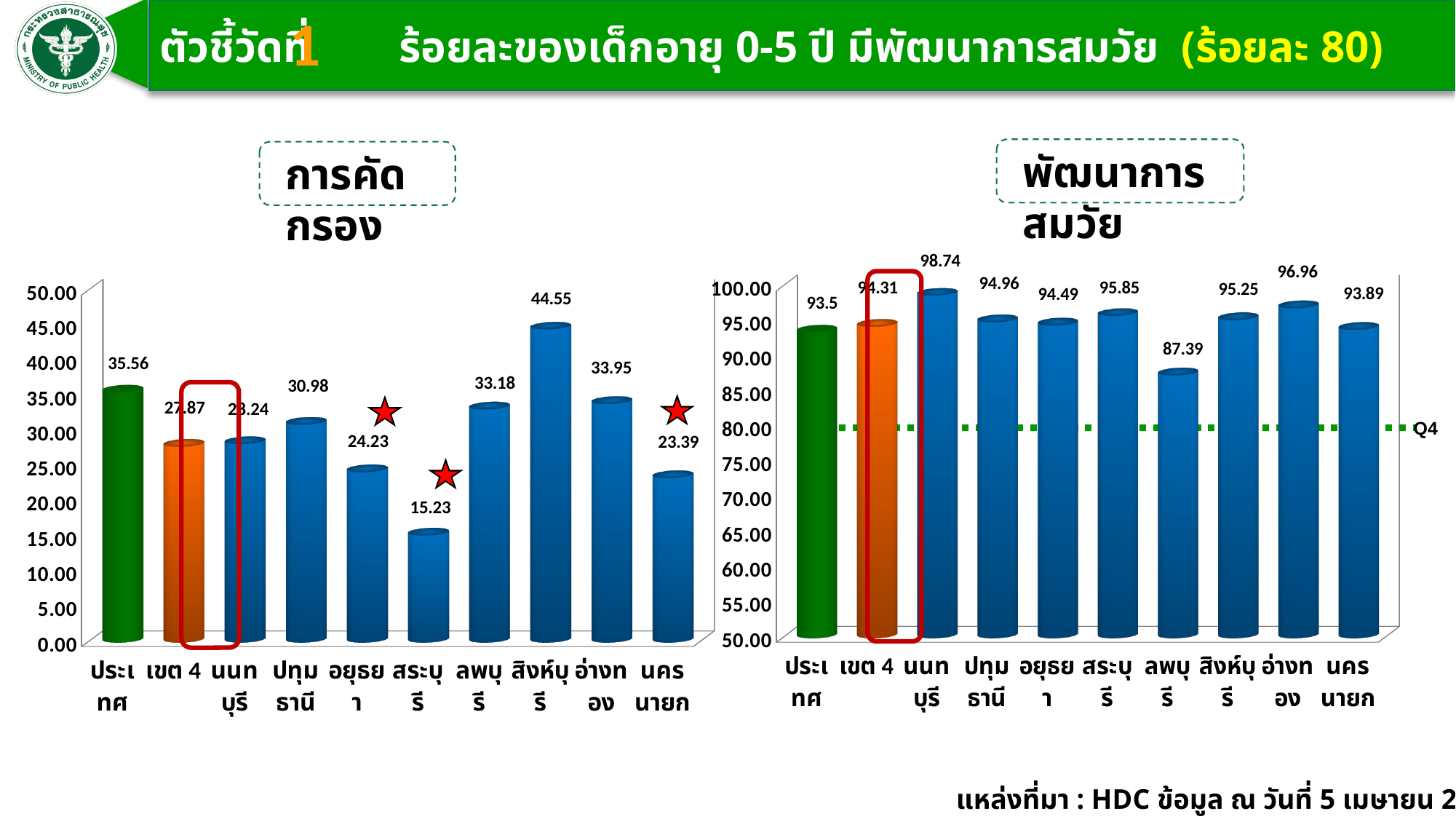
In the left chart (การคัดกรอง), which category has the lowest value? สระบุรี In the left chart (การคัดกรอง), what is the value for สิงห์บุรี? 44.55 In the right chart (พัฒนาการสมวัย), which category has the lowest value? ลพบุรี In the left chart (การคัดกรอง), what is the value for ประเทศ? 35.56 In the right chart (พัฒนาการสมวัย), what is the value for ลพบุรี? 87.39 How many categories are shown on the x axis of the left chart (การคัดกรอง)? 10 What type of chart is the right chart (พัฒนาการสมวัย)? bar chart In the right chart (พัฒนาการสมวัย), what is the value for นนทบุรี? 98.74 In the left chart (การคัดกรอง), which category has the highest value? สิงห์บุรี In the right chart (พัฒนาการสมวัย), which is larger, อ่างทอง or นครนายก? อ่างทอง In the right chart (พัฒนาการสมวัย), is the value for ลพบุรี greater or less than 90.00? less In the left chart (การคัดกรอง), what is the difference between สิงห์บุรี and สระบุรี? 29.32